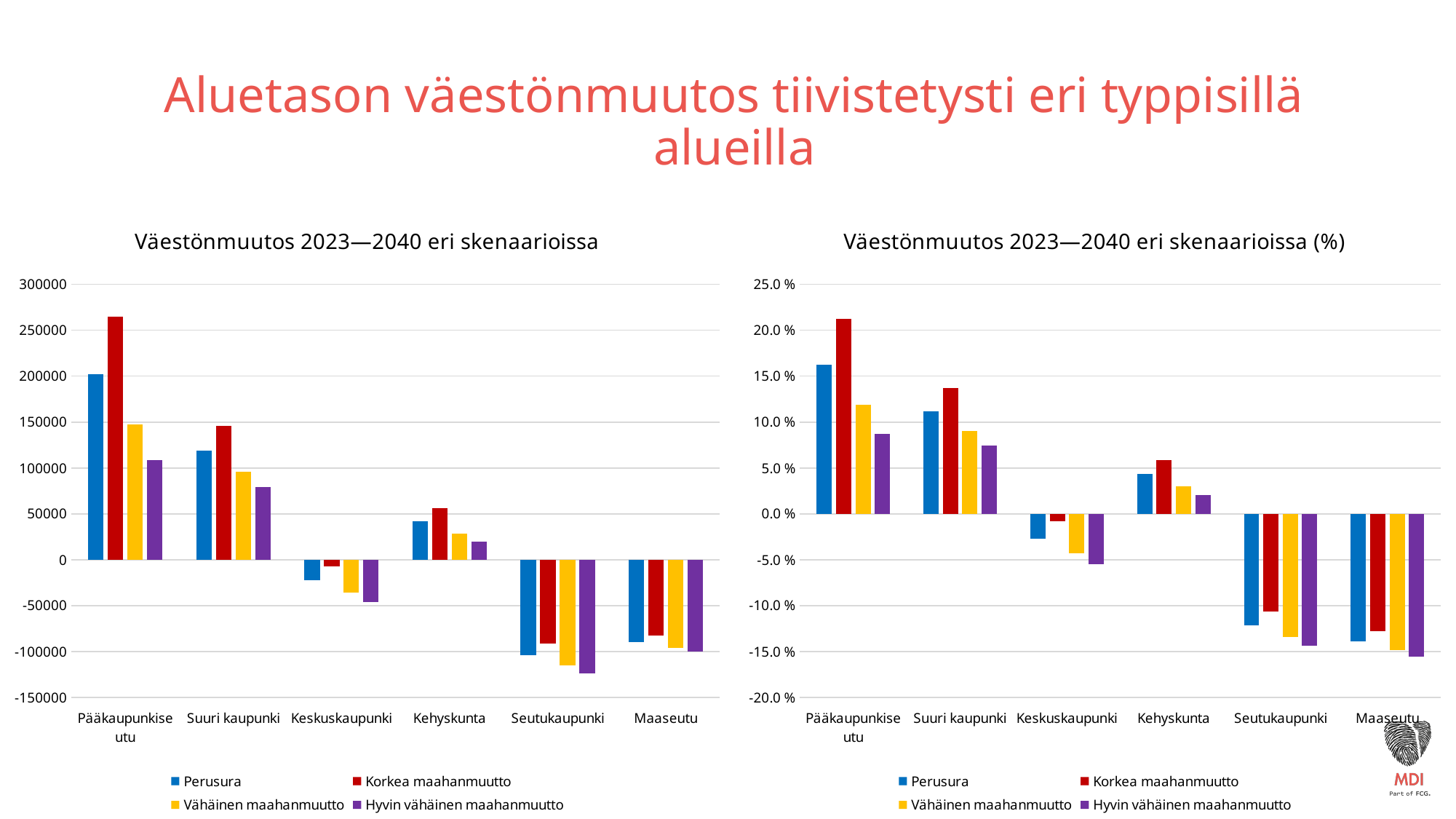
In the right chart, which series is shown in yellow according to the legend? Vähäinen maahanmuutto In the right chart (Väestönmuutos 2023—2040 eri skenaarioissa (%)), is the Korkea maahanmuutto value for Pääkaupunkiseutu greater or less than 20.0 %? greater In the right chart (Väestönmuutos 2023—2040 eri skenaarioissa (%)), how many series does the legend list? 4 In the left chart (Väestönmuutos 2023—2040 eri skenaarioissa), how many categories are shown on the x axis? 6 In the left chart (Väestönmuutos 2023—2040 eri skenaarioissa), for Kehyskunta, which is larger: the Perusura value or the Korkea maahanmuutto value? Korkea maahanmuutto What kind of chart is the left chart, Väestönmuutos 2023—2040 eri skenaarioissa? Bar chart In the right chart (Väestönmuutos 2023—2040 eri skenaarioissa (%)), is the Perusura value for Seutukaupunki greater or less than -10.0 %? less In the left chart (Väestönmuutos 2023—2040 eri skenaarioissa), which category has the lowest Hyvin vähäinen maahanmuutto value? Seutukaupunki In the right chart (Väestönmuutos 2023—2040 eri skenaarioissa (%)), which category has the lowest Perusura value? Maaseutu In the left chart (Väestönmuutos 2023—2040 eri skenaarioissa), is the Korkea maahanmuutto value for Pääkaupunkiseutu greater or less than 250000? greater In the left chart (Väestönmuutos 2023—2040 eri skenaarioissa), which category has the highest Korkea maahanmuutto value? Pääkaupunkiseutu